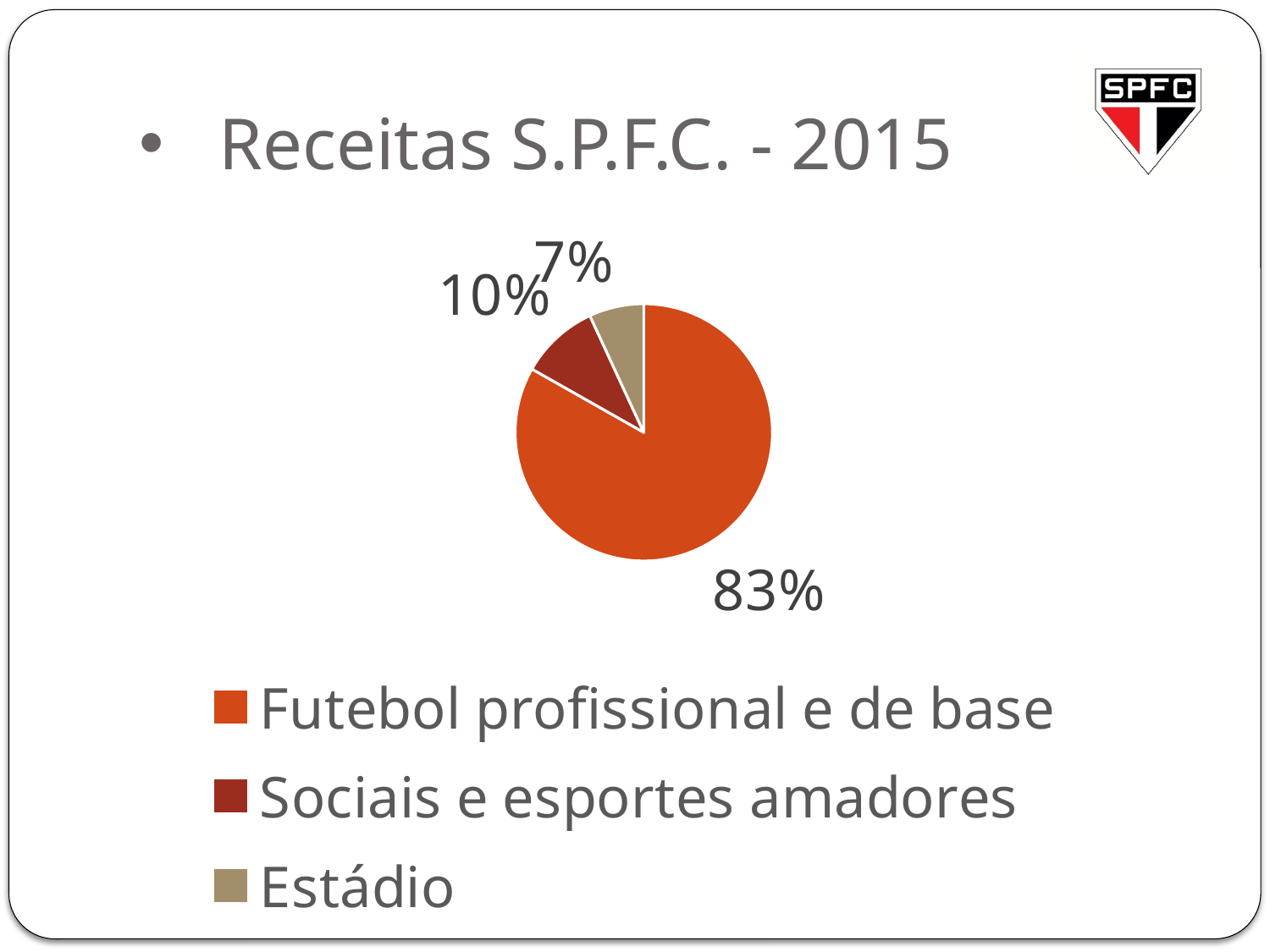
How many categories does the pie chart show? 3 What share of the pie does Estádio represent? 7% Which category has the smallest slice of the pie? Estádio What share of the pie does Futebol profissional e de base represent? 83% Which is larger, the share for Sociais e esportes amadores or the share for Estádio? Sociais e esportes amadores What is the difference in percentage points between Futebol profissional e de base and Sociais e esportes amadores? 73 Which legend entry is shown with the orange colour? Futebol profissional e de base What kind of chart is shown on the slide? pie chart Which category has the largest slice of the pie? Futebol profissional e de base What is the title of the slide containing the chart? Receitas S.P.F.C. - 2015 What share of the pie does Sociais e esportes amadores represent? 10% What is the difference in percentage points between Sociais e esportes amadores and Estádio? 3